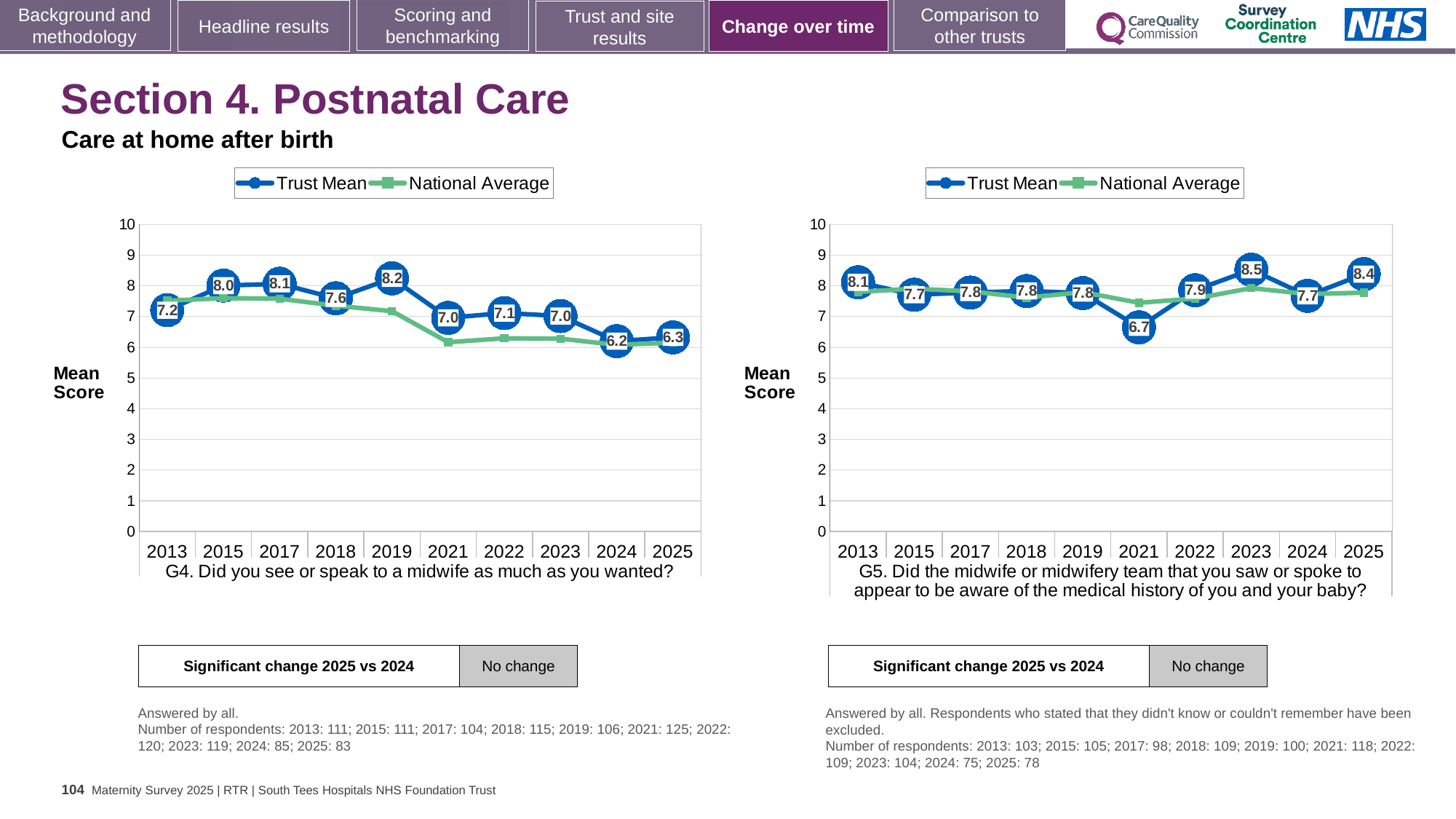
In the G5 chart (right), is the National Average for 2021 greater or less than 7? greater In the G4 chart (left), what is the Trust Mean score for 2019? 8.2 In the G4 chart (left), how many years are shown on the x axis? 10 What kind of chart is the G5 chart (right)? Line chart How many series does the legend of the G4 chart (left) list? 2 In the G5 chart (right), what is the Trust Mean score for 2021? 6.7 In the G4 chart (left), what is the difference between the Trust Mean scores for 2019 and 2024? 2.0 In the G5 chart (right), what is the difference between the Trust Mean scores for 2025 and 2024? 0.7 In the G4 chart (left), what is the Trust Mean score for 2025? 6.3 In the G5 chart (right), which year has the highest Trust Mean score? 2023 In the G5 chart (right), is the Trust Mean score for 2013 larger than the score for 2015? Yes In the G4 chart (left), which year has the lowest Trust Mean score? 2024